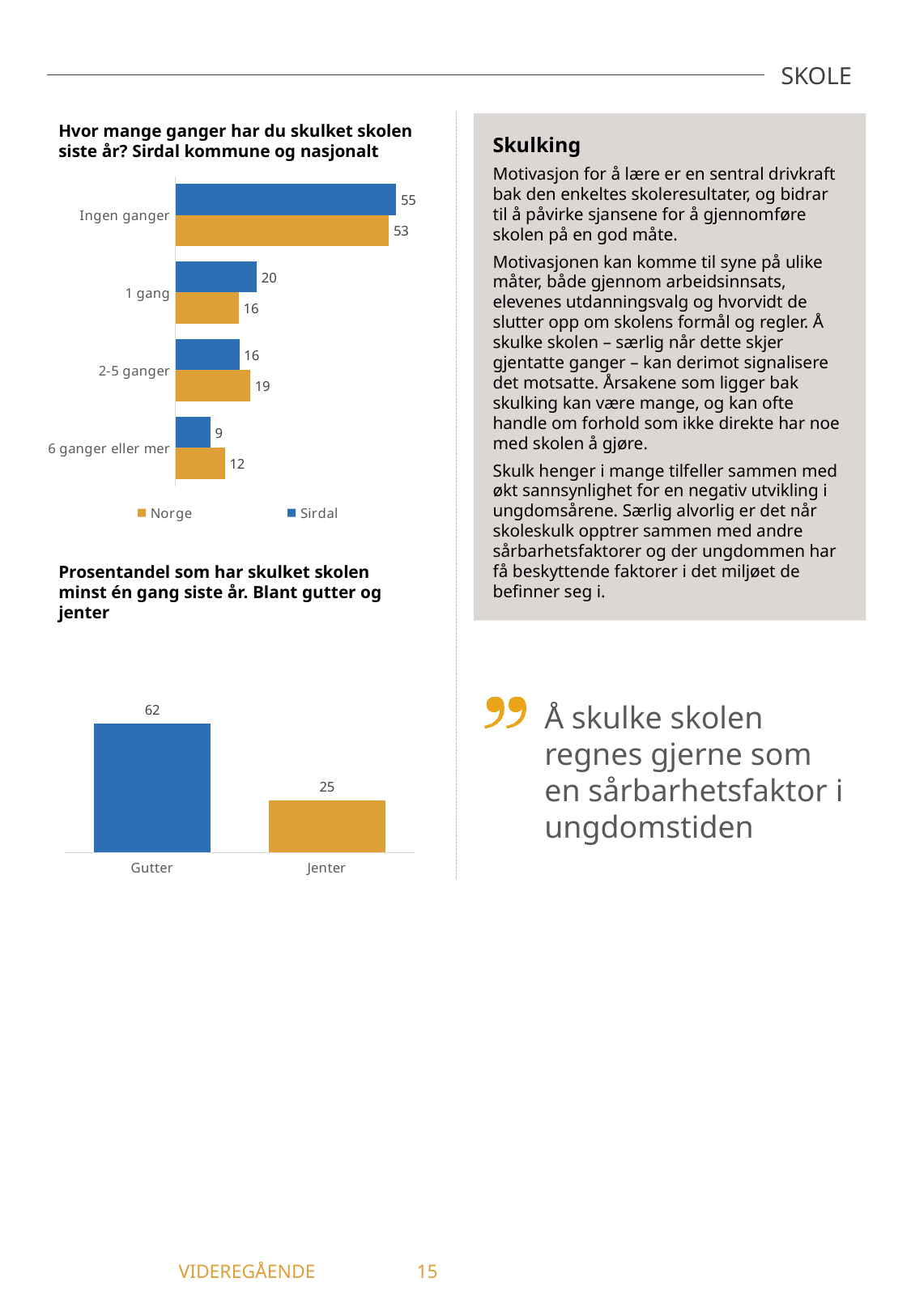
In the chart 'Hvor mange ganger har du skulket skolen siste år?', what is the value for Norge in the category '6 ganger eller mer'? 12 In the chart 'Hvor mange ganger har du skulket skolen siste år?', what is the value for Norge in the category '2-5 ganger'? 19 In the chart 'Hvor mange ganger har du skulket skolen siste år?', which colour represents Norge? Orange In the chart 'Prosentandel som har skulket skolen minst én gang siste år', what is the difference between Gutter and Jenter? 37 In the chart 'Hvor mange ganger har du skulket skolen siste år?', what is the value for Sirdal in the category 'Ingen ganger'? 55 In the chart 'Hvor mange ganger har du skulket skolen siste år?', which category has the lowest value for Sirdal? 6 ganger eller mer In the chart 'Hvor mange ganger har du skulket skolen siste år?', which is larger in the category '2-5 ganger', Norge or Sirdal? Norge In the chart 'Prosentandel som har skulket skolen minst én gang siste år', what is the value for Gutter? 62 How many categories are shown in the chart 'Hvor mange ganger har du skulket skolen siste år?'? 4 What kind of chart is 'Hvor mange ganger har du skulket skolen siste år?'? Bar chart In the chart 'Hvor mange ganger har du skulket skolen siste år?', what is the difference between Sirdal and Norge in the category '1 gang'? 4 How many series does the legend of the chart 'Hvor mange ganger har du skulket skolen siste år?' list? 2